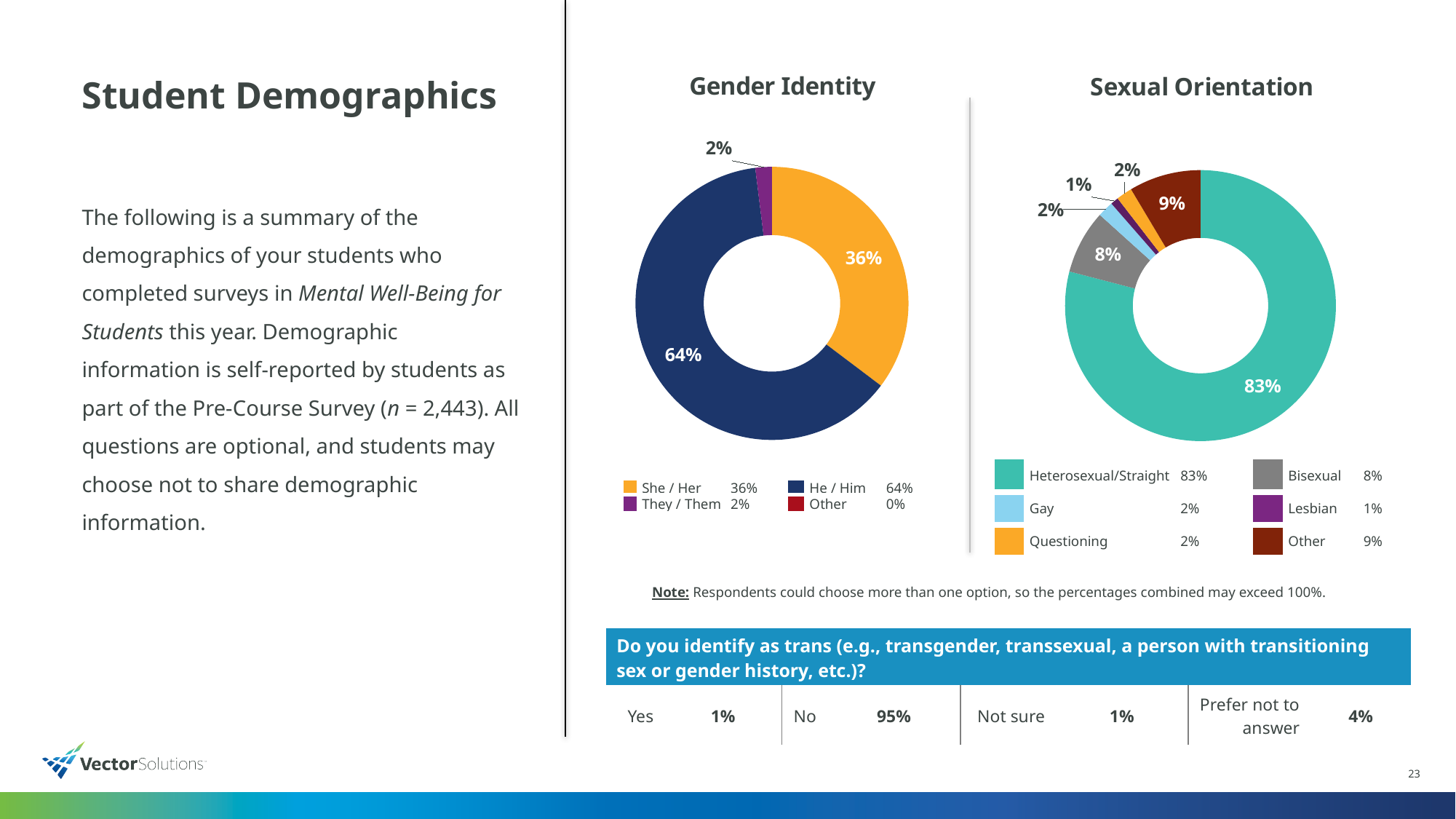
In the Gender Identity chart, what is the difference between the He / Him and She / Her percentages? 28% In the Sexual Orientation chart, what percentage of students identify as Bisexual? 8% In the Gender Identity chart, what percentage of students identify as She / Her? 36% In the Sexual Orientation chart, what percentage of students identify as Lesbian? 1% In the Sexual Orientation chart, which category has the smallest share? Lesbian In the Sexual Orientation chart, which is larger, Bisexual or Other? Other In the Sexual Orientation chart, what percentage of students identify as Heterosexual/Straight? 83% In the Gender Identity chart, what percentage of students identify as They / Them? 2% In the Gender Identity chart, what percentage of students identify as He / Him? 64% In the Gender Identity chart, which category has the largest share? He / Him In the Sexual Orientation chart, how many categories does the legend list? 6 What kind of chart is the Gender Identity chart? Pie (doughnut) chart